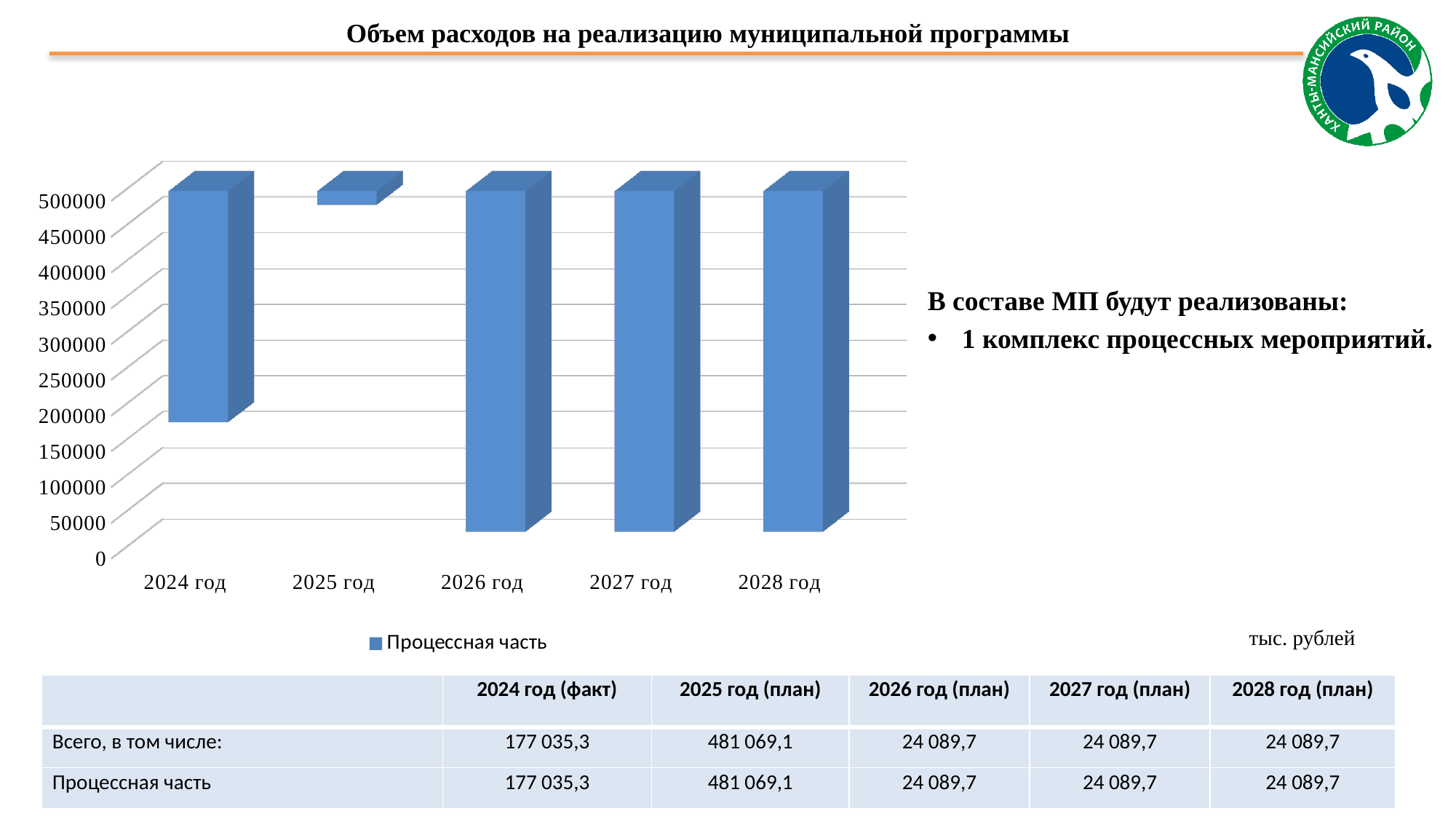
What is the value for 2025 год in the chart? 481 069,1 How many years are shown on the x axis of the chart? 5 What is the difference between the values for 2024 год and 2028 год? 152 945,6 What kind of chart is shown on the slide? Bar chart What is the value for 2027 год in the chart? 24 089,7 Which is larger, the value for 2024 год or the value for 2026 год? 2024 год Which is larger, the value for 2024 год or the value for 2025 год? 2025 год What is the value for 2024 год in the chart? 177 035,3 How many series does the chart legend list? 1 What is the difference between the values for 2025 год and 2024 год? 304 033,8 What is the name of the series shown in the chart legend? Процессная часть Which year has the highest value in the chart? 2025 год